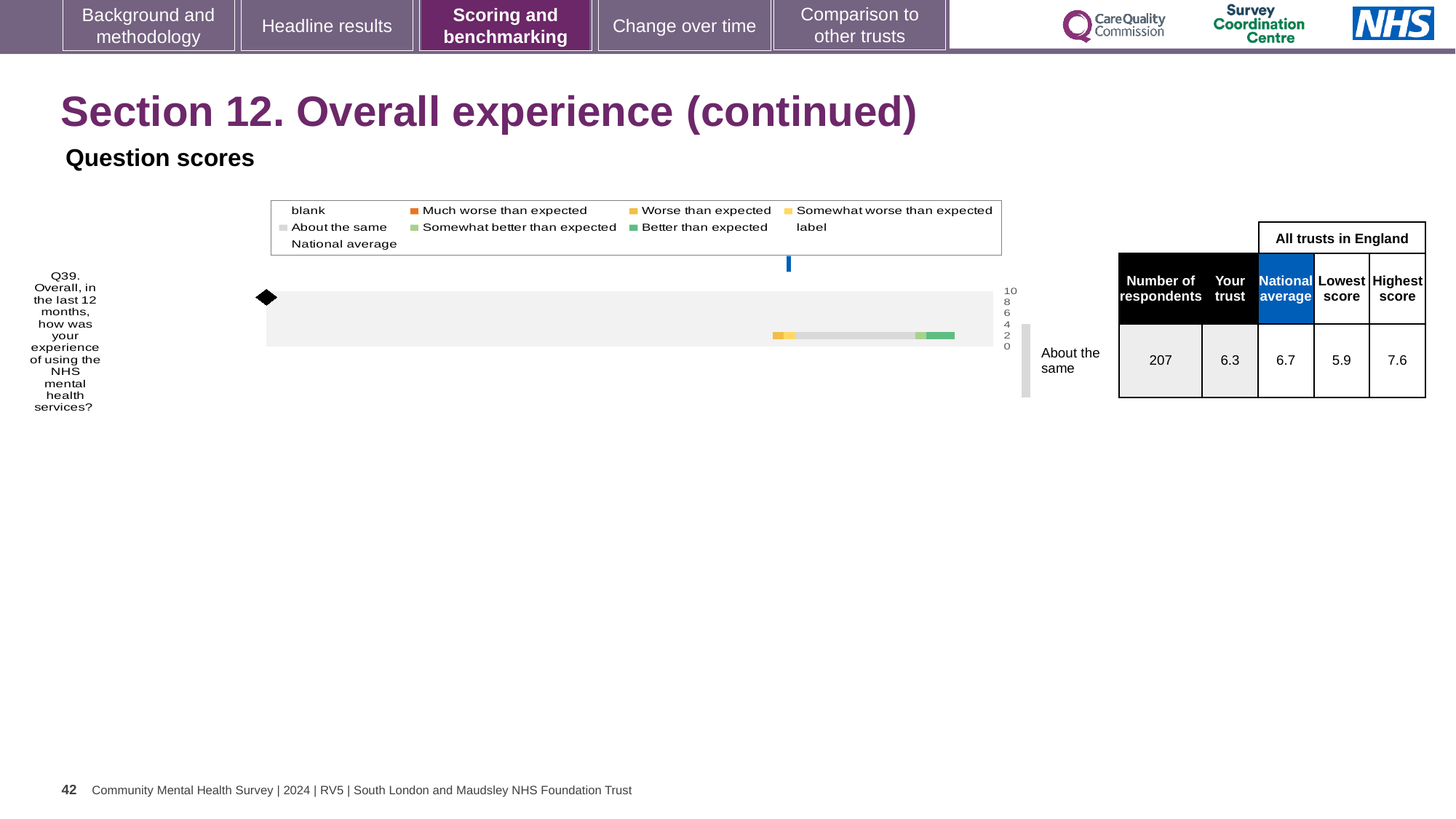
Which legend entry is shown in orange on the chart? Much worse than expected What is the difference between the highest score (7.6) and the lowest score (5.9) for Q39? 1.7 Which is larger for Q39: the trust's score or the national average? National average What is the lowest score among all trusts in England for Q39? 5.9 How is the trust's result for Q39 categorised relative to expectations? About the same What is the score for 'Your trust' for Q39 on the overall experience chart? 6.3 What is the difference between the national average (6.7) and the trust's score (6.3) for Q39? 0.4 How many respondents answered Q39? 207 What kind of chart is used to show the Q39 question score? Bar chart How many questions are plotted on the chart? 1 What is the national average score shown for Q39? 6.7 What is the highest score among all trusts in England for Q39? 7.6